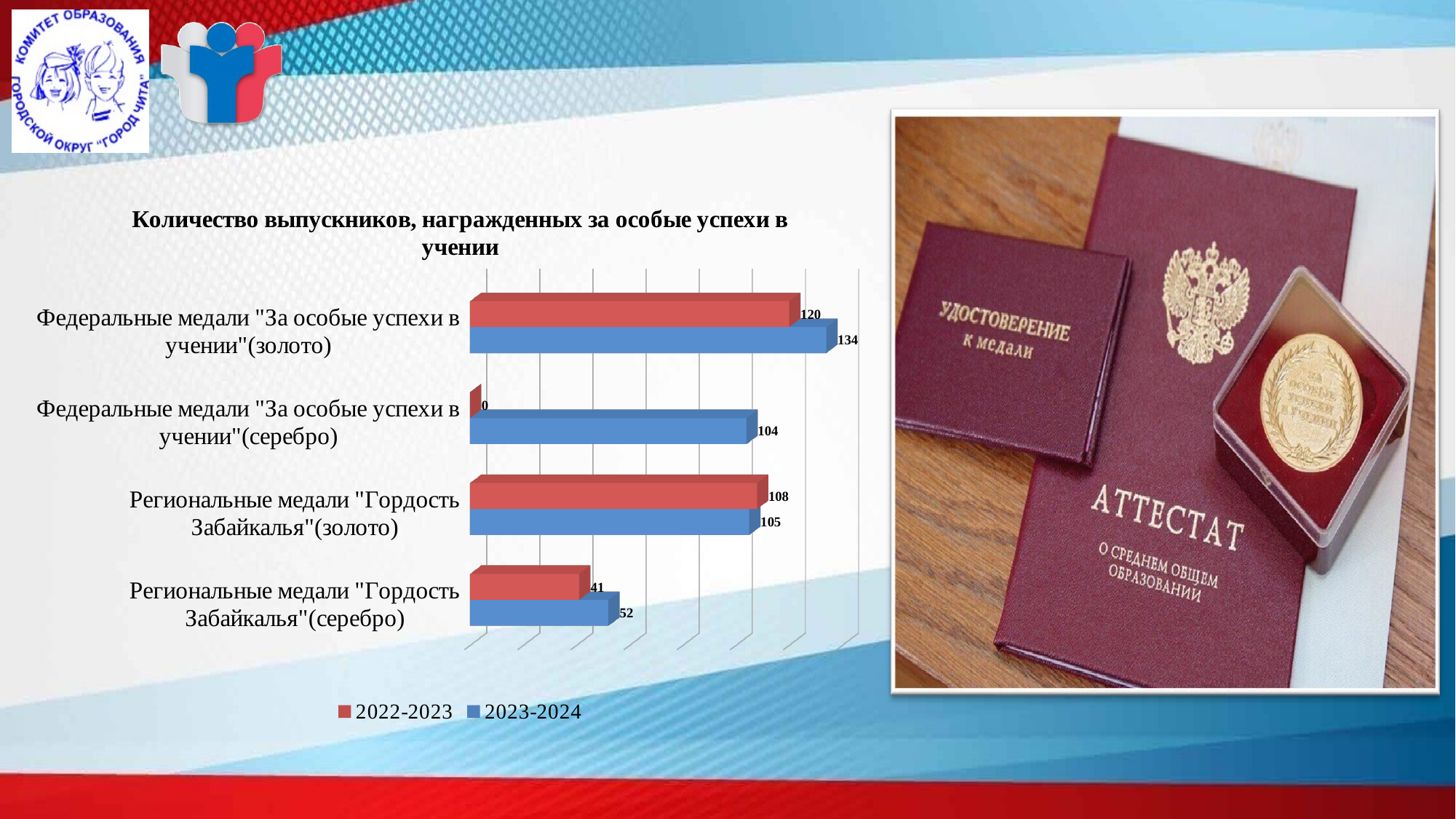
What is the title of the chart? Количество выпускников, награжденных за особые успехи в учении What type of chart is shown on the slide? bar chart Which is larger for Региональные медали "Гордость Забайкалья"(серебро): the 2022-2023 value or the 2023-2024 value? 2023-2024 How many categories are shown in the chart? 4 Which category has the highest value in the 2023-2024 series? Федеральные медали "За особые успехи в учении"(золото) How many series does the legend list? 2 What is the difference between the 2023-2024 and 2022-2023 values for Федеральные медали "За особые успехи в учении"(золото)? 14 What is the value for Региональные медали "Гордость Забайкалья"(золото) in 2022-2023? 108 What is the value for Региональные медали "Гордость Забайкалья"(серебро) in 2023-2024? 52 What is the value for Федеральные медали "За особые успехи в учении"(серебро) in 2022-2023? 0 What is the value for Федеральные медали "За особые успехи в учении"(золото) in 2023-2024? 134 Which category has the lowest value in the 2022-2023 series? Федеральные медали "За особые успехи в учении"(серебро)